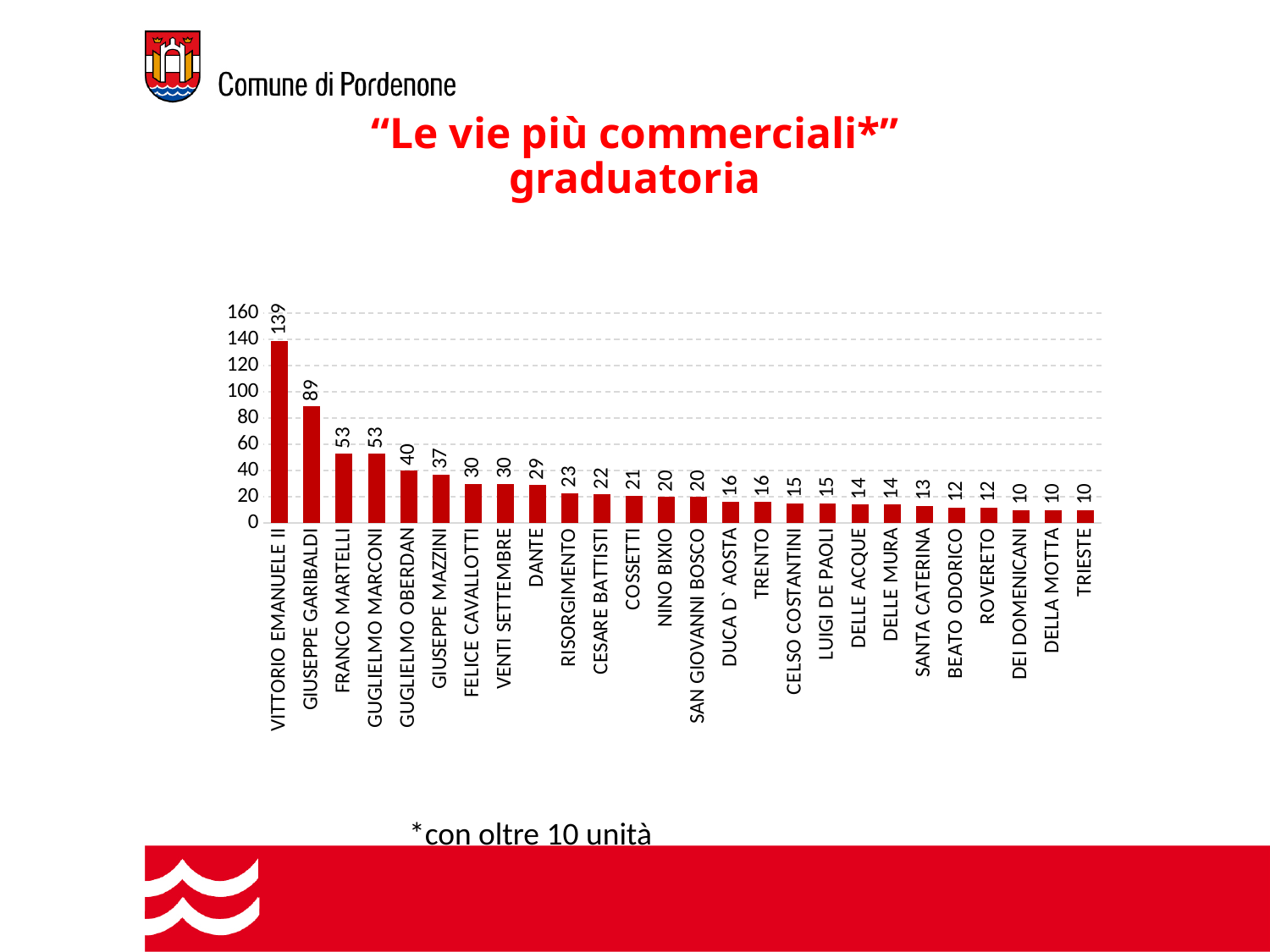
What is the value for SANTA CATERINA? 13 Do the values rise or fall from left to right along the x axis? fall What is the value for GIUSEPPE GARIBALDI? 89 What is the value for DANTE? 29 Is the value for FRANCO MARTELLI greater or less than 40? greater How many categories are shown in the chart? 26 Which category has the highest value? VITTORIO EMANUELE II What kind of chart is shown on the slide? bar chart Which is larger, the value for GUGLIELMO OBERDAN or the value for GIUSEPPE MAZZINI? GUGLIELMO OBERDAN What is the value for VITTORIO EMANUELE II? 139 What is the lowest value shown in the chart? 10 What is the difference between the values for VITTORIO EMANUELE II and GIUSEPPE GARIBALDI? 50